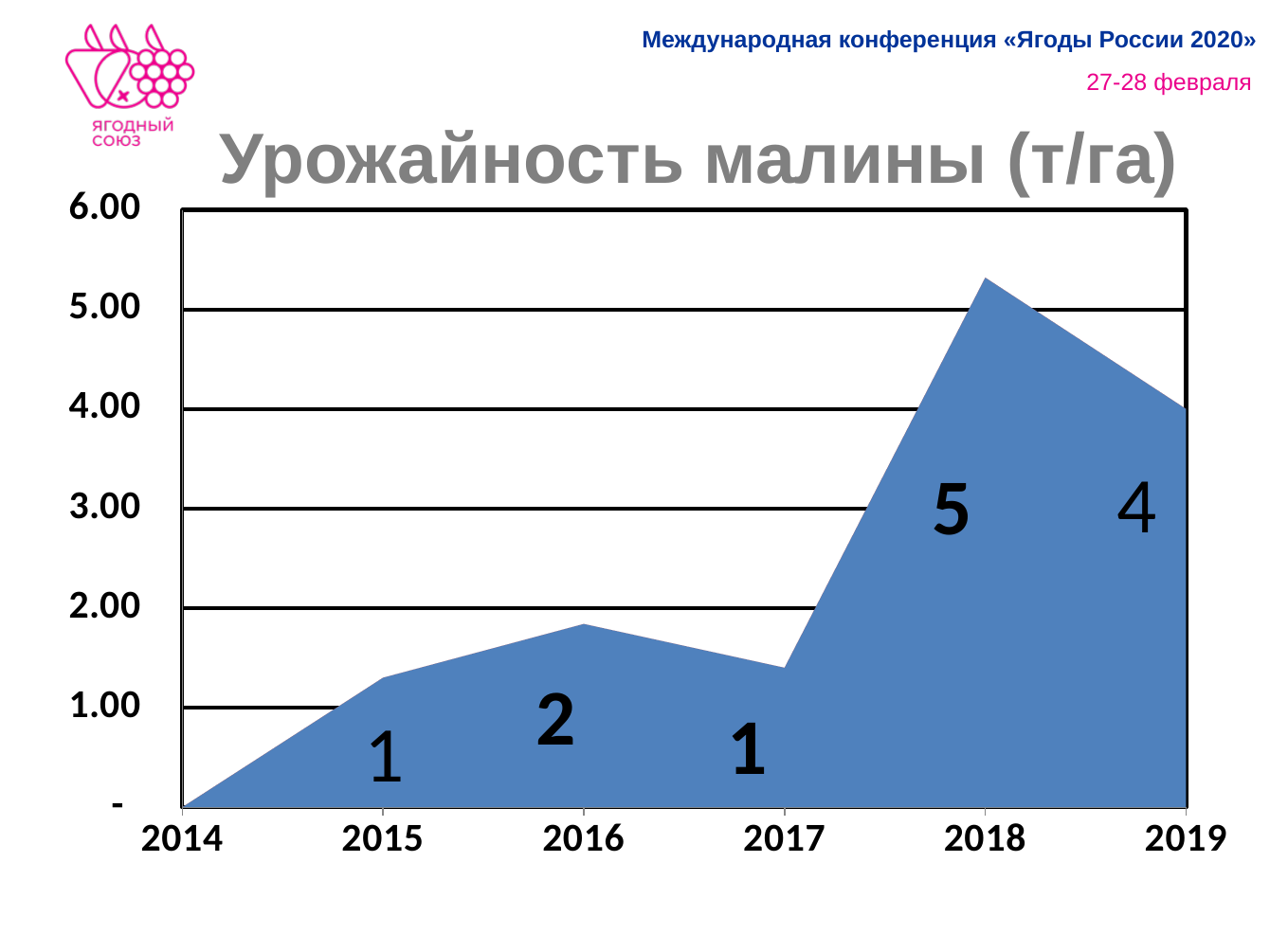
Which year has the lowest raspberry yield? 2014 What is the data label shown for 2016? 2 What kind of chart is shown on the slide? area chart How many years are plotted on the x axis? 6 What is the data label shown for 2018? 5 What is the title of the chart? Урожайность малины (т/га) Is the value for 2016 greater or less than 2.00? less Does the yield rise or fall from 2018 to 2019? fall Is the value for 2018 greater or less than 5.00? greater Which year has the larger value, 2016 or 2017? 2016 What is the data label shown for 2019? 4 Which year has the highest raspberry yield? 2018